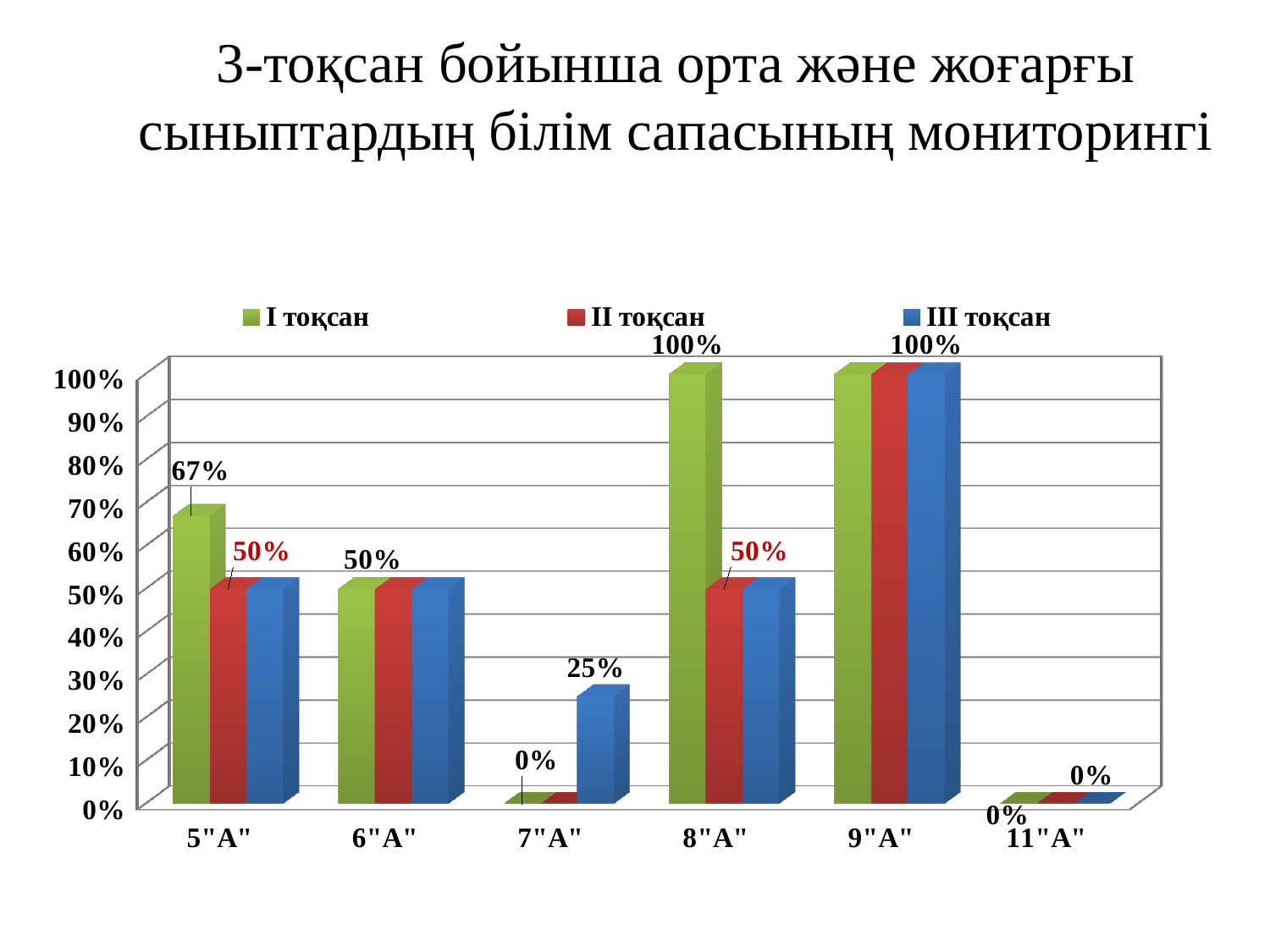
Which category has the lowest value in the III тоқсан series? 11"A" What is the value for 7"A" in the III тоқсан series? 25% How many categories are shown on the x axis? 6 How many series does the legend list? 3 What is the value for 5"A" in the II тоқсан series? 50% Is the III тоқсан value for 6"A" greater or less than 60%? less What is the value for 5"A" in the I тоқсан series? 67% What is the difference between the I тоқсан and II тоқсан values for 5"A"? 17 percentage points What is the value for 8"A" in the I тоқсан series? 100% Which is larger in the I тоқсан series: the value for 5"A" or the value for 6"A"? 5"A" Which category has the highest value in the III тоқсан series? 9"A" What is the value for 7"A" in the I тоқсан series? 0%